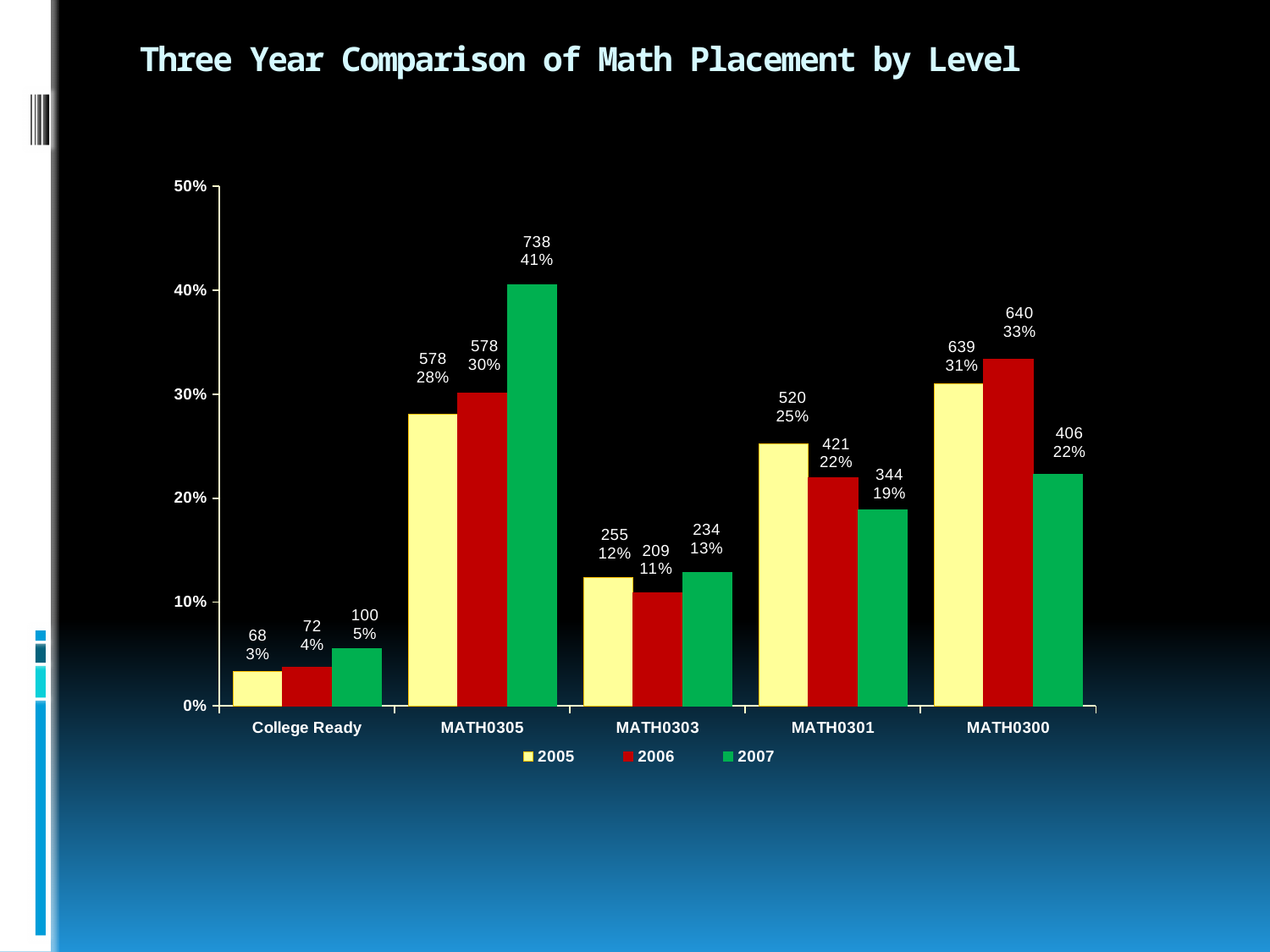
How many categories are shown on the x axis? 5 What count is shown for MATH0301 in 2005? 520 What percentage is shown for College Ready in 2006? 4% What kind of chart is shown on the slide? bar chart What is the difference in percentage points between 2007 and 2005 for MATH0305? 13 How many series does the legend list? 3 Which category has the highest percentage for 2007? MATH0305 What is the title of the slide? Three Year Comparison of Math Placement by Level Which category has the lowest percentage for 2005? College Ready Which is larger for MATH0300: the 2006 percentage or the 2007 percentage? 2006 What percentage is shown for MATH0305 in 2007? 41% Is the value for MATH0303 in 2006 greater or less than 20%? less